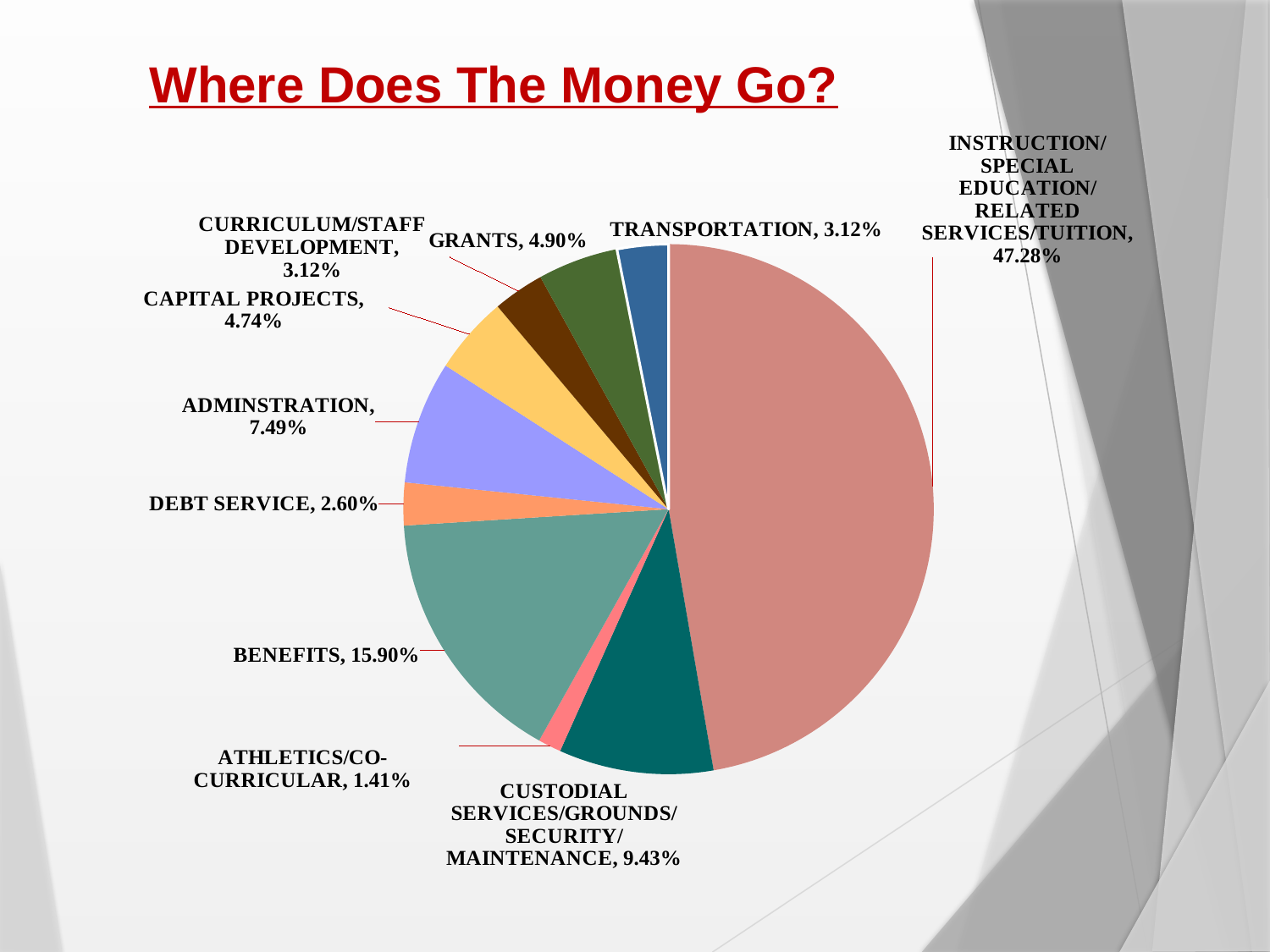
What percentage is shown for DEBT SERVICE? 2.60% What share of the pie goes to INSTRUCTION/SPECIAL EDUCATION/RELATED SERVICES/TUITION? 47.28% What percentage is shown for ADMINSTRATION? 7.49% What is the title of the slide's chart? Where Does The Money Go? What kind of chart is shown on the slide? pie chart What percentage is shown for CUSTODIAL SERVICES/GROUNDS/SECURITY/MAINTENANCE? 9.43% Which category has the largest slice of the pie? INSTRUCTION/SPECIAL EDUCATION/RELATED SERVICES/TUITION Which is larger, the share for GRANTS or the share for CAPITAL PROJECTS? GRANTS What share of the pie goes to BENEFITS? 15.90% Which category has the smallest slice of the pie? ATHLETICS/CO-CURRICULAR How many slices does the pie chart have? 10 What is the difference between the BENEFITS share and the ADMINSTRATION share? 8.41%